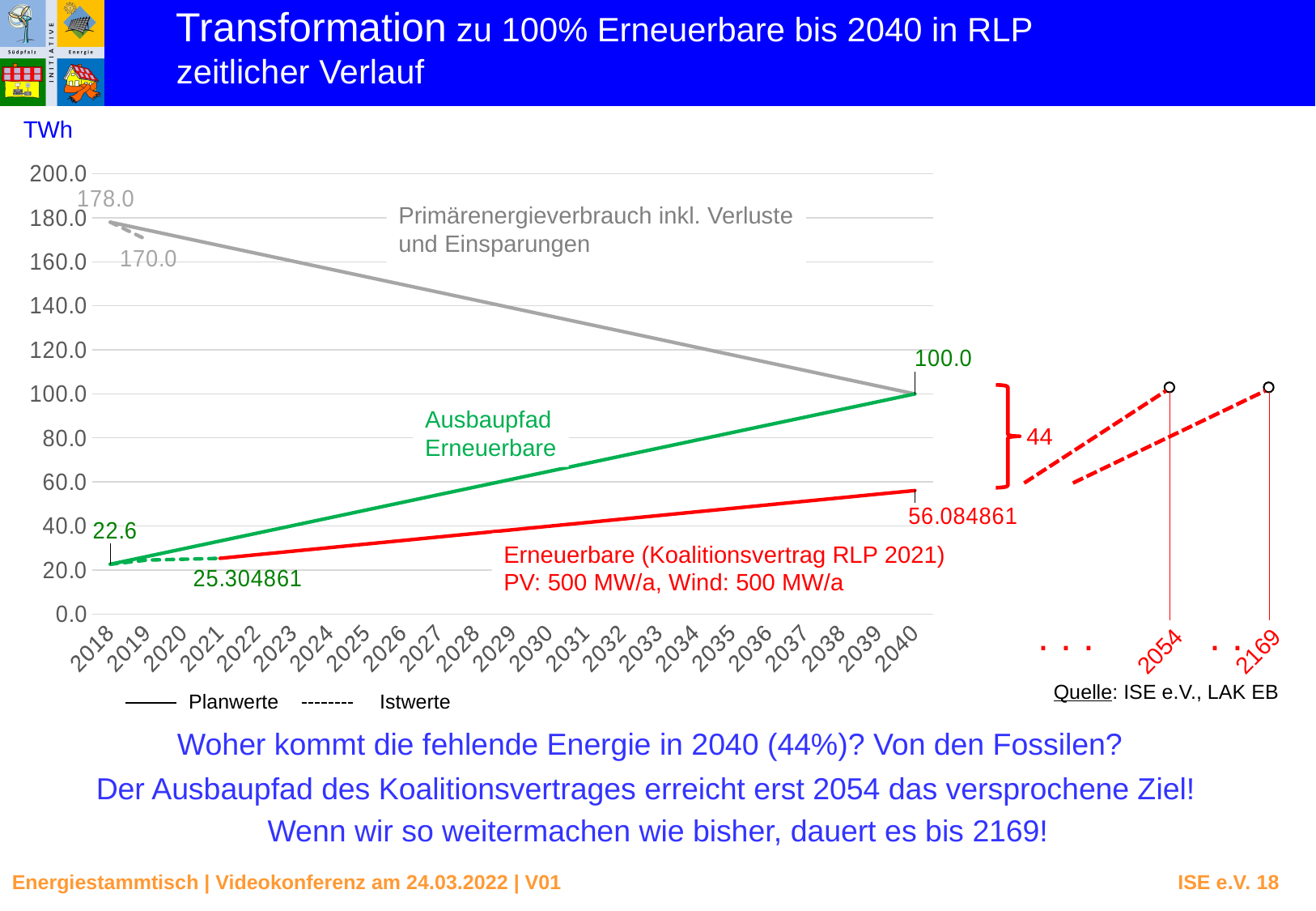
How many years are labelled on the main x axis from 2018 to 2040? 23 Does the Primärenergieverbrauch line rise or fall from 2018 to 2040? fall What type of chart is shown on the slide? line chart What is the value of the Primärenergieverbrauch line in 2018? 178.0 What value does the Erneuerbare (Koalitionsvertrag RLP 2021) line reach in 2040? 56.084861 What unit is shown on the y axis of the chart? TWh What is the value of the Ausbaupfad Erneuerbare line in 2018? 22.6 Does the Ausbaupfad Erneuerbare line rise or fall from 2018 to 2040? rise What is the value of the Erneuerbare (Koalitionsvertrag RLP 2021) line in 2021? 25.304861 What value do the Primärenergieverbrauch and Ausbaupfad Erneuerbare lines meet at in 2040? 100.0 In 2030, is the Ausbaupfad Erneuerbare line greater or less than 60.0? greater What is the difference between the Ausbaupfad Erneuerbare value and the Erneuerbare (Koalitionsvertrag RLP 2021) value in 2040? 43.915139